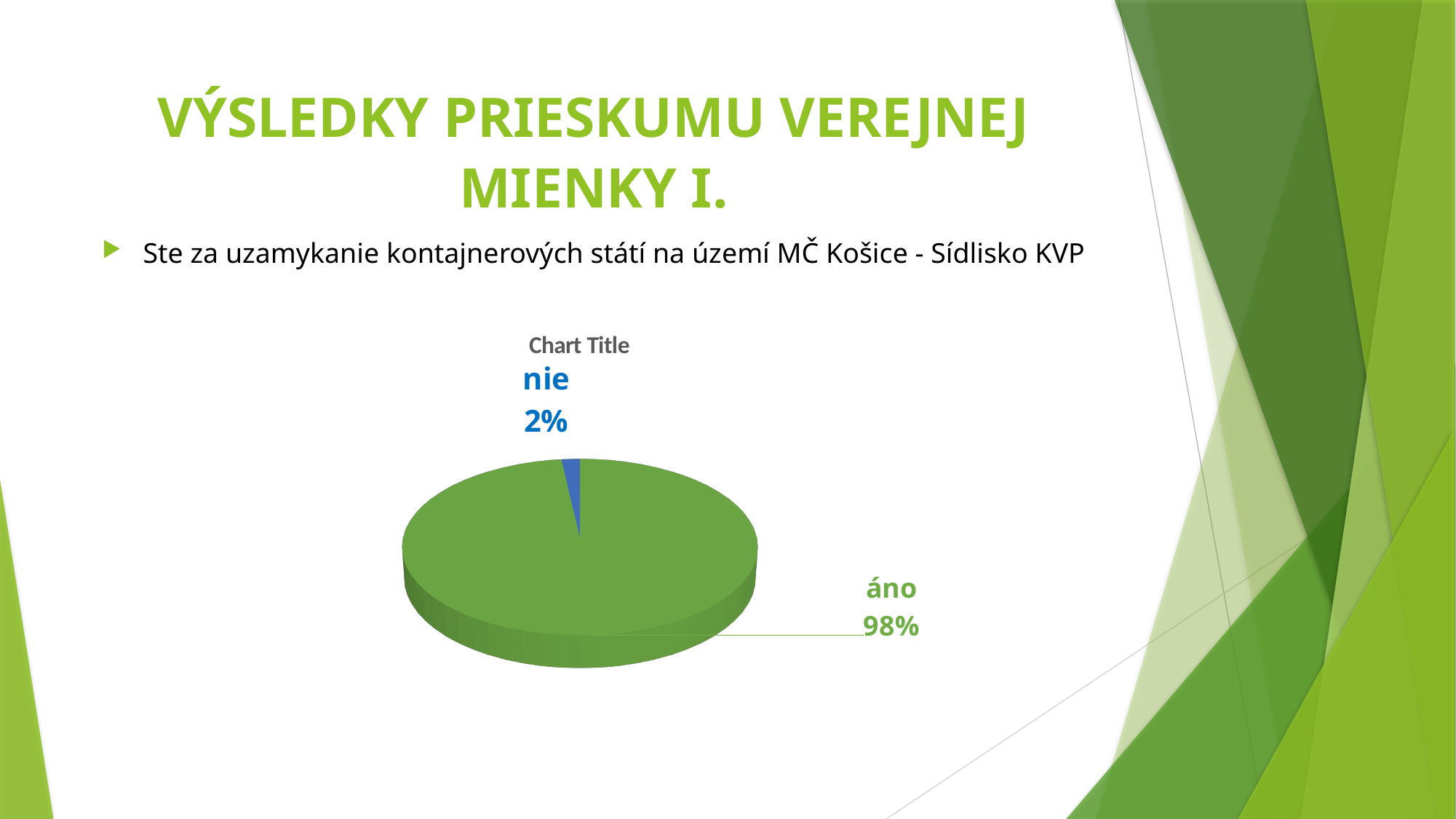
What is the title shown above the pie chart? Chart Title Which slice of the pie is the largest? áno What share of the pie does the "áno" slice represent? 98% What colour is the "nie" slice of the pie? blue Which is larger, the "áno" slice or the "nie" slice? áno How many slices does the pie chart have? 2 What share of the pie does the "nie" slice represent? 2% What is the difference in percentage points between the "áno" and "nie" slices? 96% Which slice of the pie is the smallest? nie What kind of chart is shown on the slide? pie chart